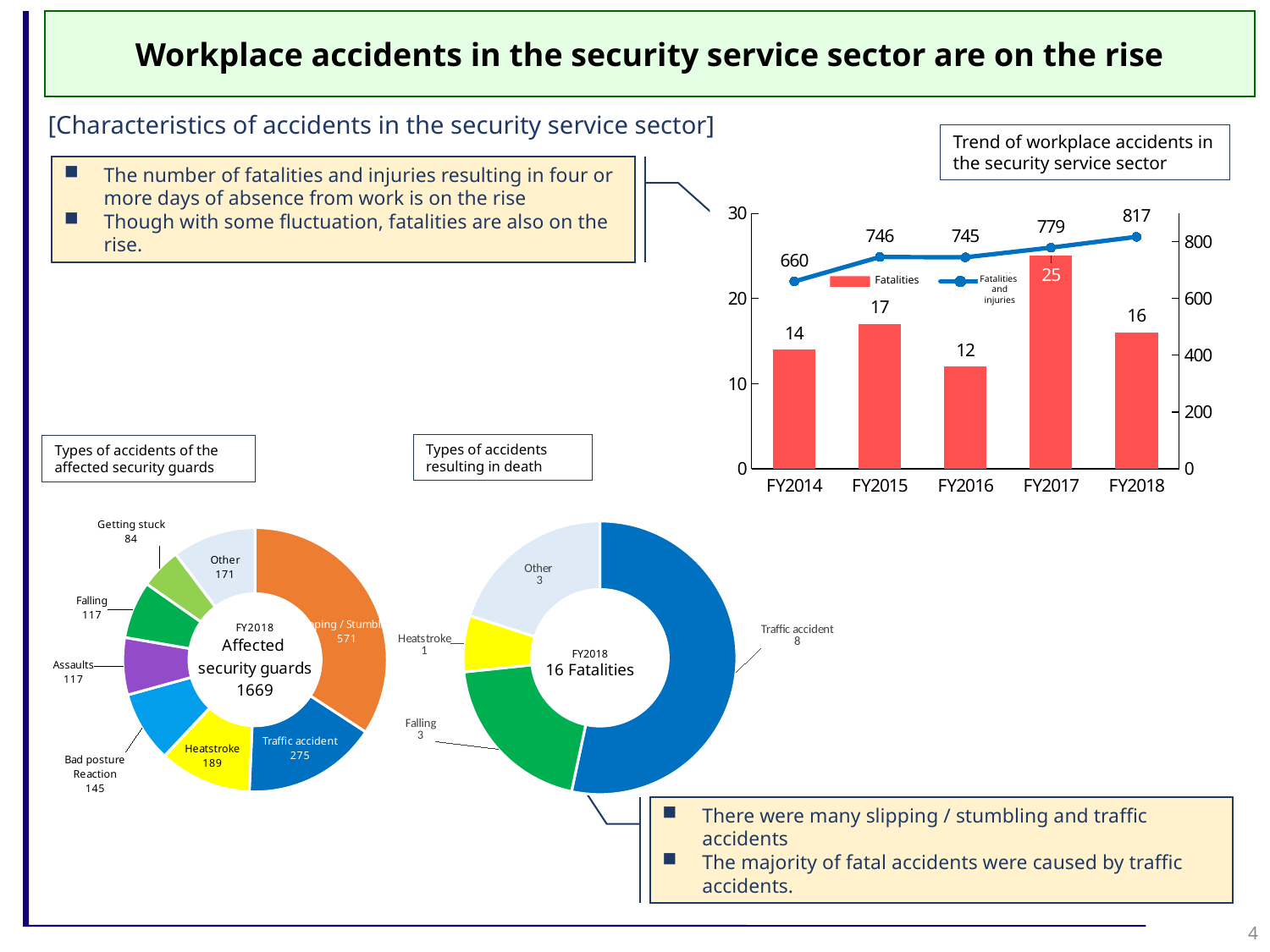
In the 'Types of accidents resulting in death' chart, how many fatalities were caused by traffic accidents? 8 In the 'Trend of workplace accidents in the security service sector' chart, what is the difference in fatalities and injuries between FY2018 and FY2014? 157 In the 'Trend of workplace accidents in the security service sector' chart, which fiscal year has the highest number of fatalities and injuries? FY2018 In the 'Types of accidents of the affected security guards' chart, how many accidents were traffic accidents? 275 In the 'Trend of workplace accidents in the security service sector' chart, what is the number of fatalities in FY2017? 25 In the 'Types of accidents of the affected security guards' chart, which is larger: Heatstroke or Bad posture reaction? Heatstroke In the 'Types of accidents of the affected security guards' chart, which type of accident has the largest number? Slipping / Stumbling In the 'Trend of workplace accidents in the security service sector' chart, how many fiscal years are shown on the x axis? 5 What kind of chart is the 'Types of accidents resulting in death' chart? Donut (pie) chart In the 'Trend of workplace accidents in the security service sector' chart, which fiscal year has the lowest number of fatalities? FY2016 In the 'Trend of workplace accidents in the security service sector' chart, what is the value for fatalities and injuries in FY2018? 817 In the 'Trend of workplace accidents in the security service sector' chart, how many series does the legend list? 2